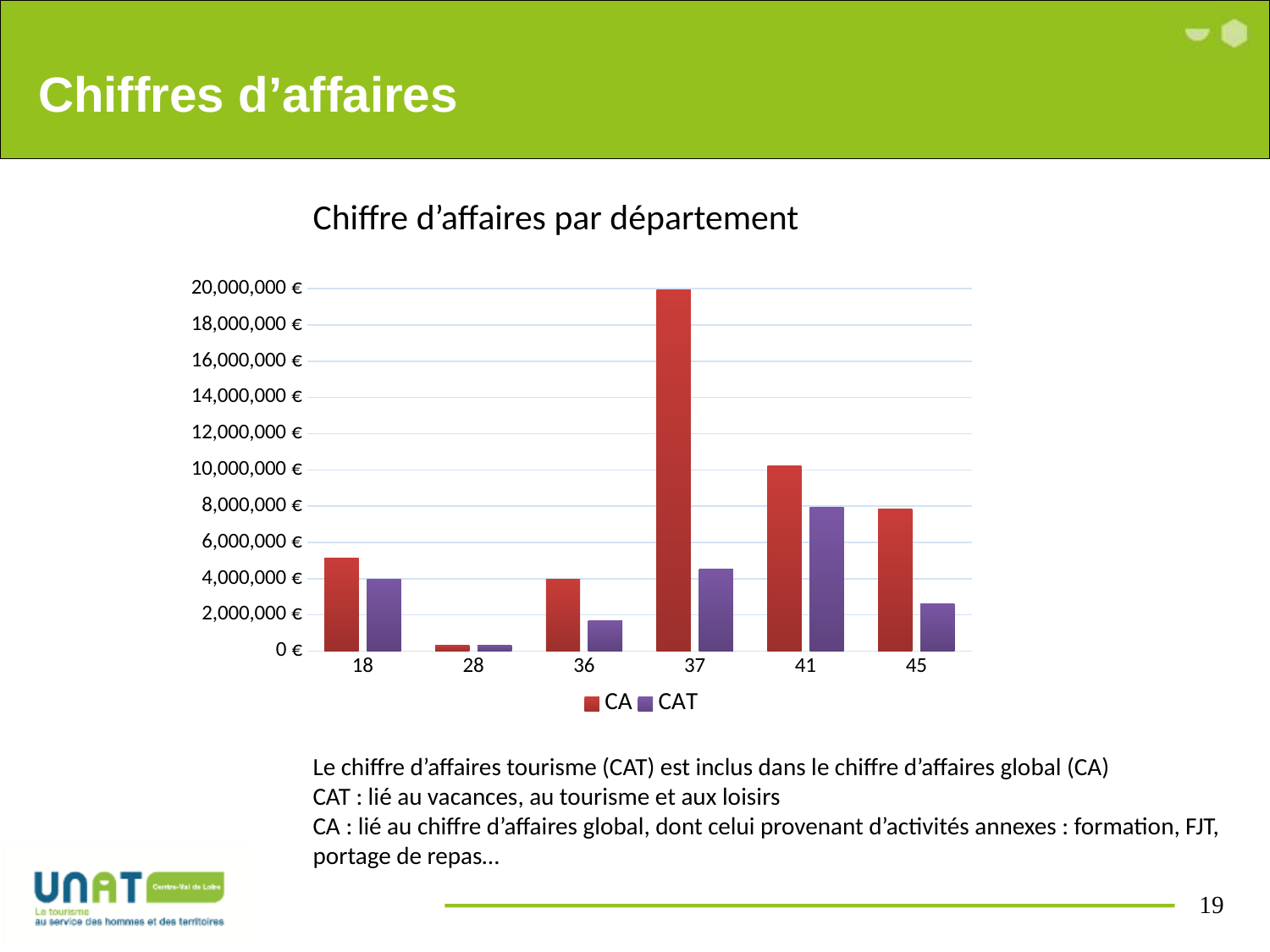
Which department has the highest CA value? 37 Which department has the highest CAT value? 41 What is the title of the chart? Chiffre d’affaires par département Is the CAT value for department 36 greater or less than 2,000,000 €? less How many departments are shown on the x axis? 6 Which is larger, the CA value for department 41 or the CA value for department 45? department 41 Is the CA value for department 37 greater or less than 18,000,000 €? greater Which department has the lowest CA value? 28 Is the CAT value for department 41 greater or less than 6,000,000 €? greater Which is larger, the CAT value for department 45 or the CAT value for department 36? department 45 How many series does the legend list? 2 What kind of chart is shown on the slide? bar chart